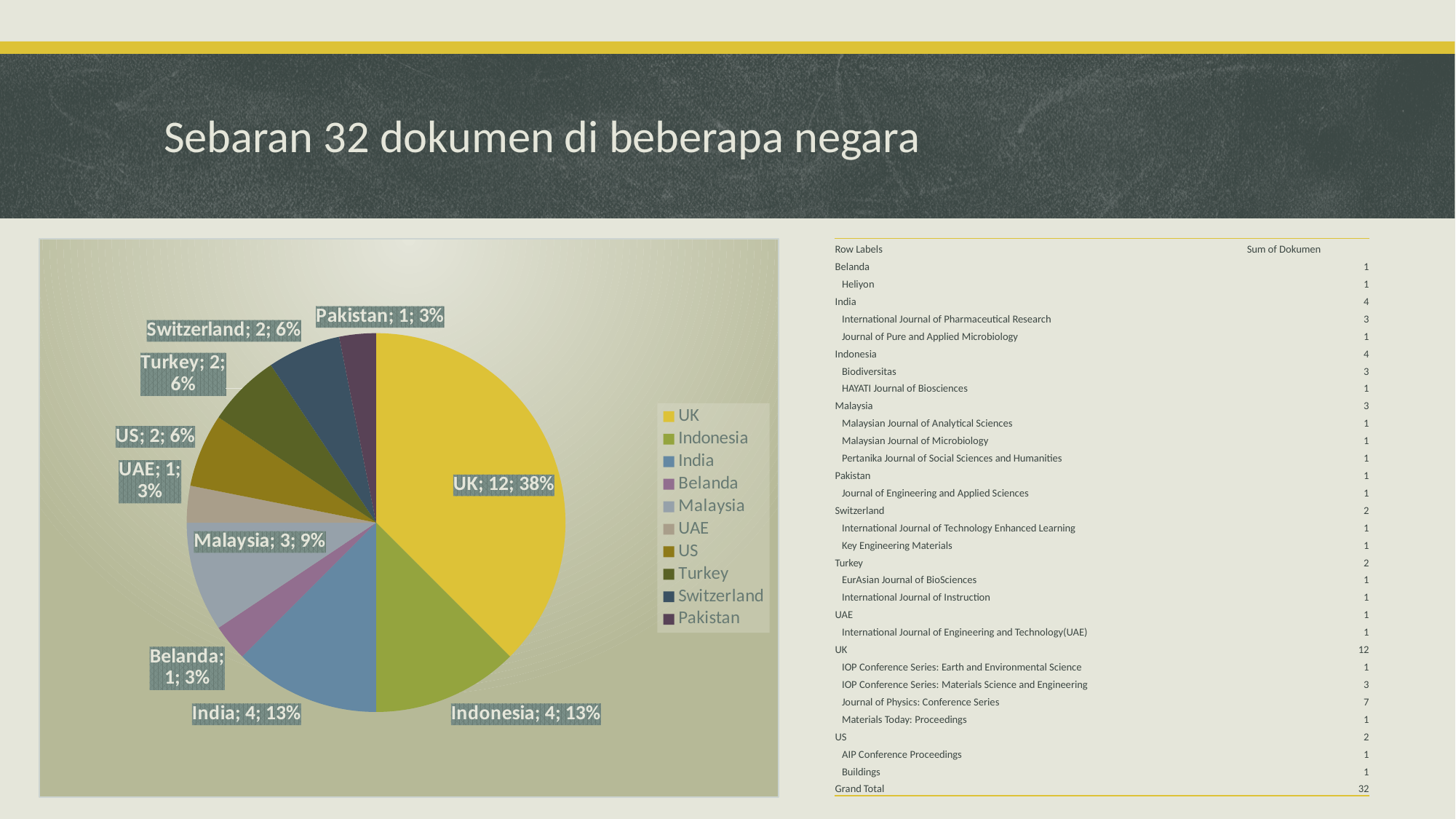
What type of chart is shown on the slide? Pie chart How many entries does the pie chart legend list? 10 Which country has the largest slice in the pie chart? UK What is the value shown for Malaysia in the pie chart? 3 How many categories (countries) are shown in the pie chart? 10 What percentage share of the pie does the UK slice have? 38% What percentage share does Malaysia have in the pie chart? 9% What is the title of the slide containing the pie chart? Sebaran 32 dokumen di beberapa negara What percentage share does Pakistan have in the pie chart? 3% How many documents does the UK slice represent in the pie chart? 12 Which is larger in the pie chart, the value for Malaysia or the value for Turkey? Malaysia What is the difference between the UK value and the Indonesia value in the pie chart? 8